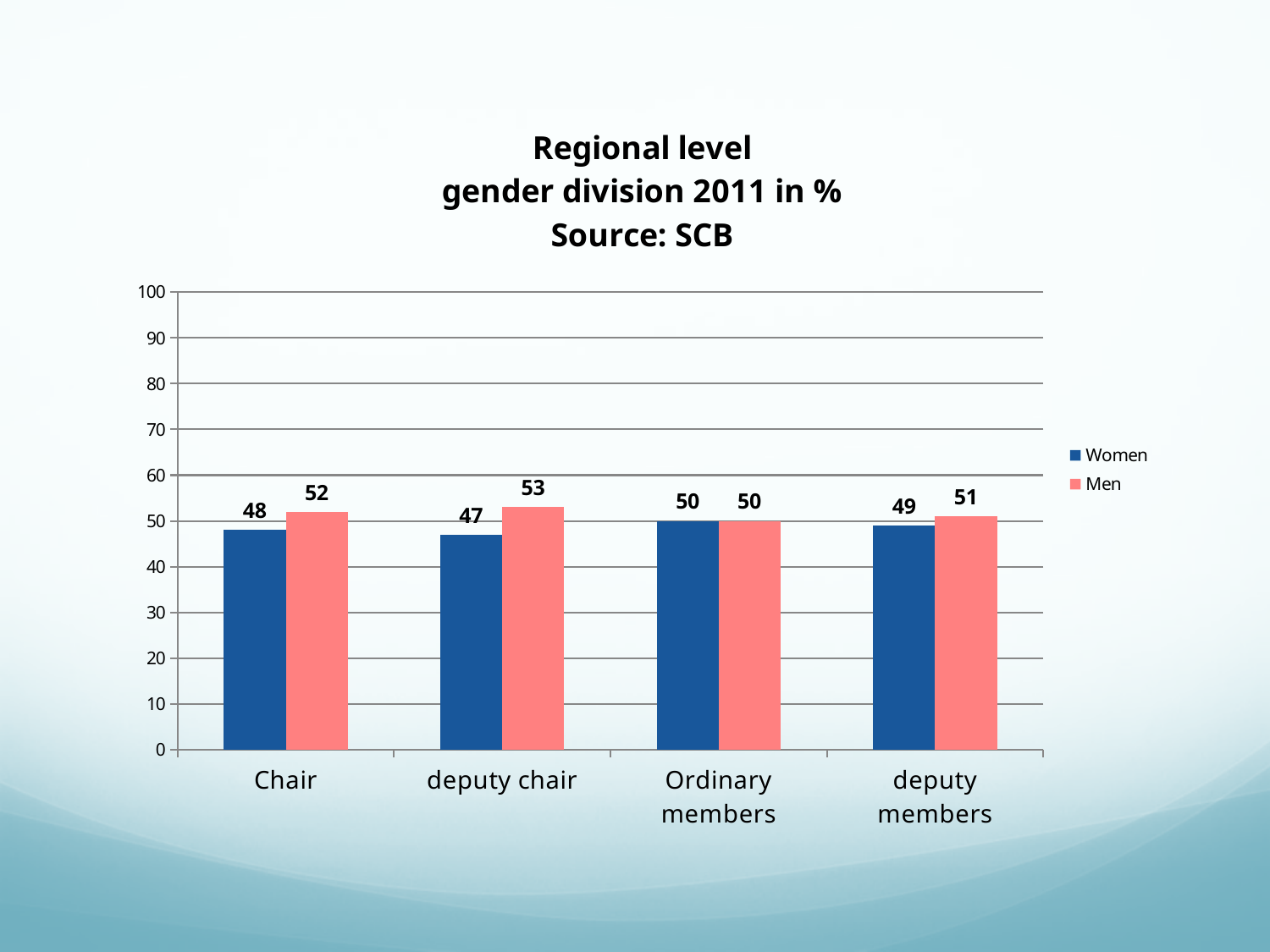
What is the source named in the chart title? SCB What is the value for Men in the deputy chair category? 53 What kind of chart is shown on the slide? bar chart How many series does the legend list? 2 What is the value for Men in the Ordinary members category? 50 What is the difference between the Men and Women values in the deputy chair category? 6 What is the value for Women in the deputy members category? 49 In which category is the Women value lowest? deputy chair Which is larger in the Chair category, the Women value or the Men value? Men How many categories are shown on the x axis? 4 What is the value for Women in the Chair category? 48 In which category is the Men value highest? deputy chair